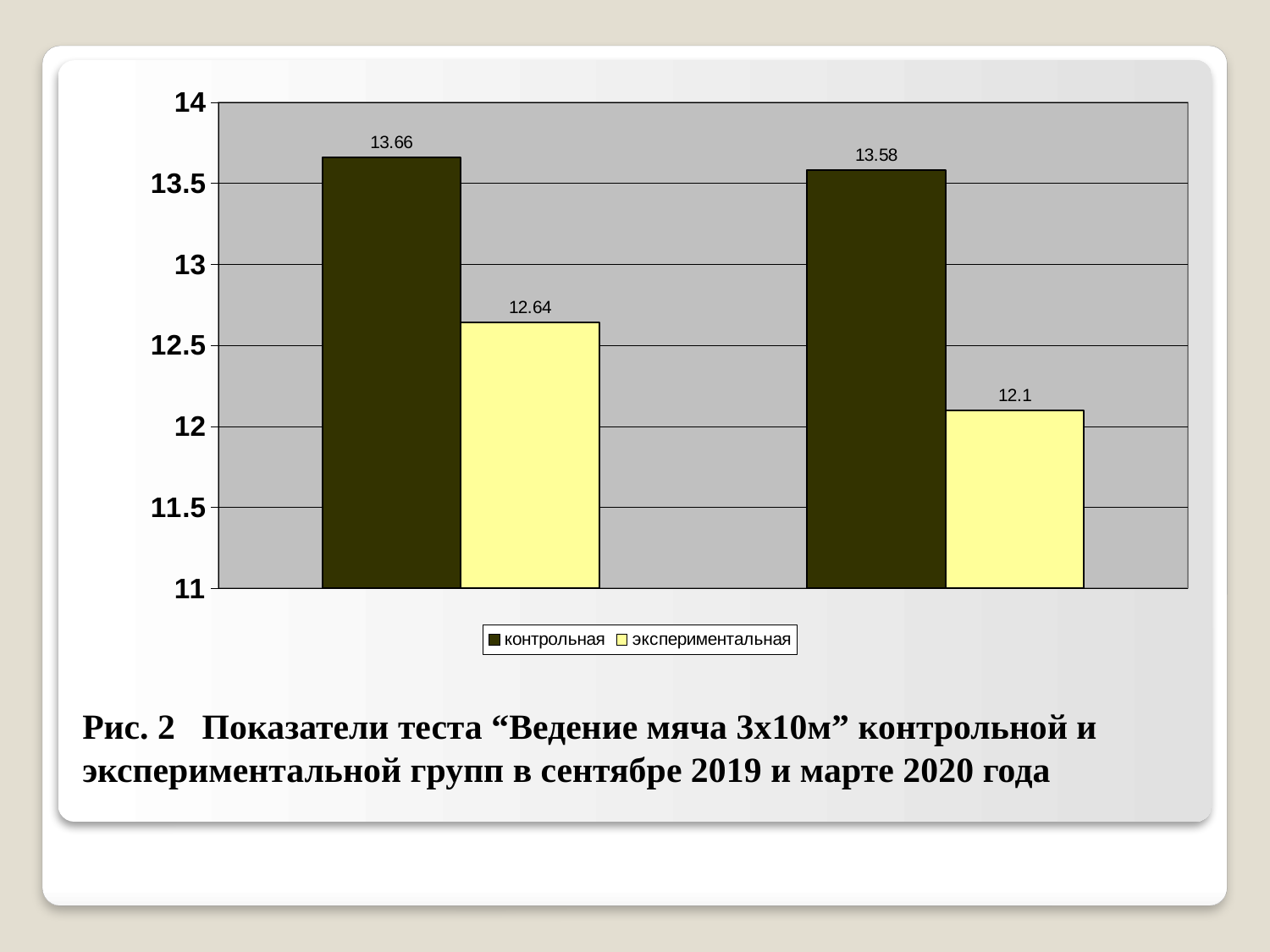
What is the value of the контрольная series in the right group of bars? 13.58 In the left group of bars, which series has the larger value, контрольная or экспериментальная? контрольная Which bar has the highest value on the chart? контрольная in the left group (13.66) Which bar has the lowest value on the chart? экспериментальная in the right group (12.1) What kind of chart is shown on the slide? Bar chart What is the value of the контрольная series in the left group of bars? 13.66 Does the экспериментальная value rise or fall from the left group to the right group? Fall What is the difference between the контрольная and экспериментальная values in the right group of bars? 1.48 What is the value of the экспериментальная series in the left group of bars? 12.64 What is the value of the экспериментальная series in the right group of bars? 12.1 What is the difference between the контрольная and экспериментальная values in the left group of bars? 1.02 How many series does the legend list? 2